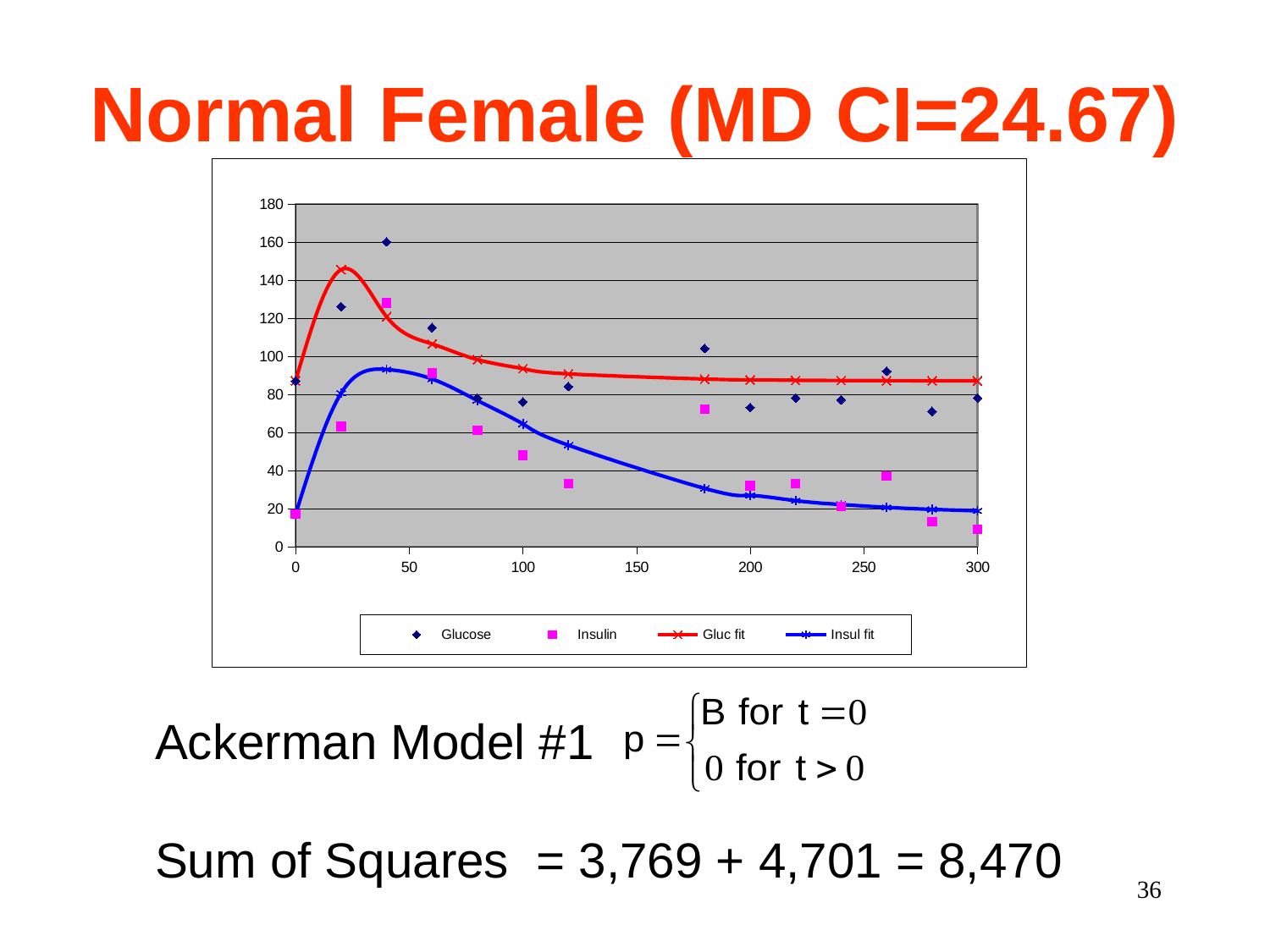
Which series are listed in the chart legend? Glucose, Insulin, Gluc fit, Insul fit What colour is the Gluc fit line? Red Is the Glucose value at x = 40 greater or less than 140? greater Is the Insulin value at x = 300 greater or less than 20? less Is the Glucose value at x = 200 greater or less than 80? less What kind of chart is shown on the slide? Scatter chart with fitted lines Does the Insul fit line rise or fall between x = 50 and x = 300? Fall At x = 260, which is larger, the Glucose value or the Insulin value? Glucose At which x value does the Insulin series reach its lowest point? 300 How many series does the chart legend list? 4